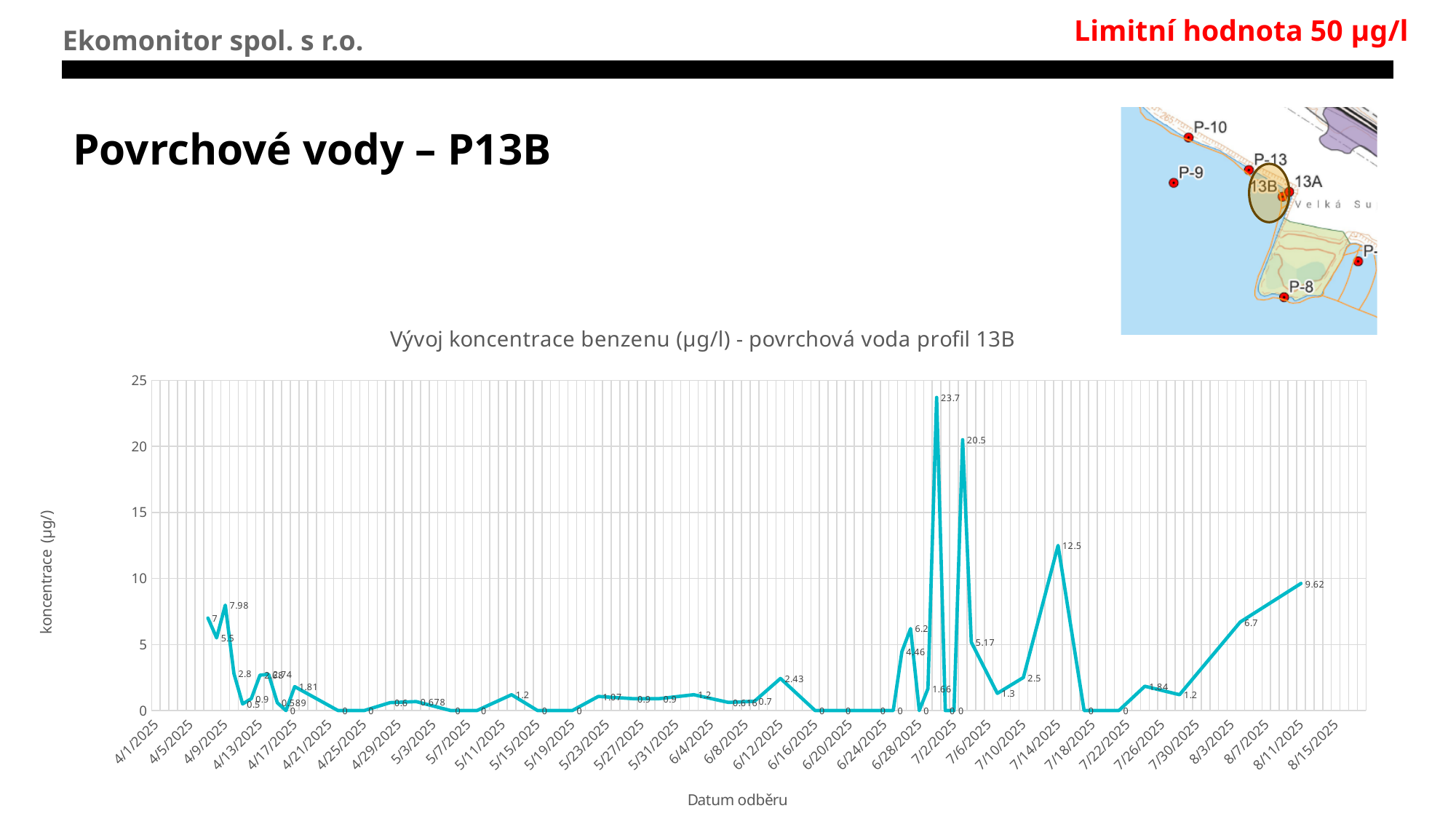
What is the value of the first peak, at 4/9/2025? 7.98 What is the difference between the two highest peaks, 23.7 and 20.5? 3.2 What kind of chart is shown on the slide? line chart Is the value of the last data point (9.62) greater or less than 10? less Is the highest value on the chart greater or less than 20? greater Which is larger: the peak at 7/14/2025 or the peak labeled 20.5 in early July? the peak labeled 20.5 What is the label of the vertical axis of the chart? koncentrace (µg/l) What is the title of the chart? Vývoj koncentrace benzenu (µg/l) - povrchová voda profil 13B Between the points labeled 6.7 and 9.62 at the right end of the chart, do the values rise or fall? rise What is the highest benzene concentration value labeled on the chart? 23.7 What is the value of the peak at 7/14/2025? 12.5 What is the value of the last data point on the chart (around 8/11/2025)? 9.62